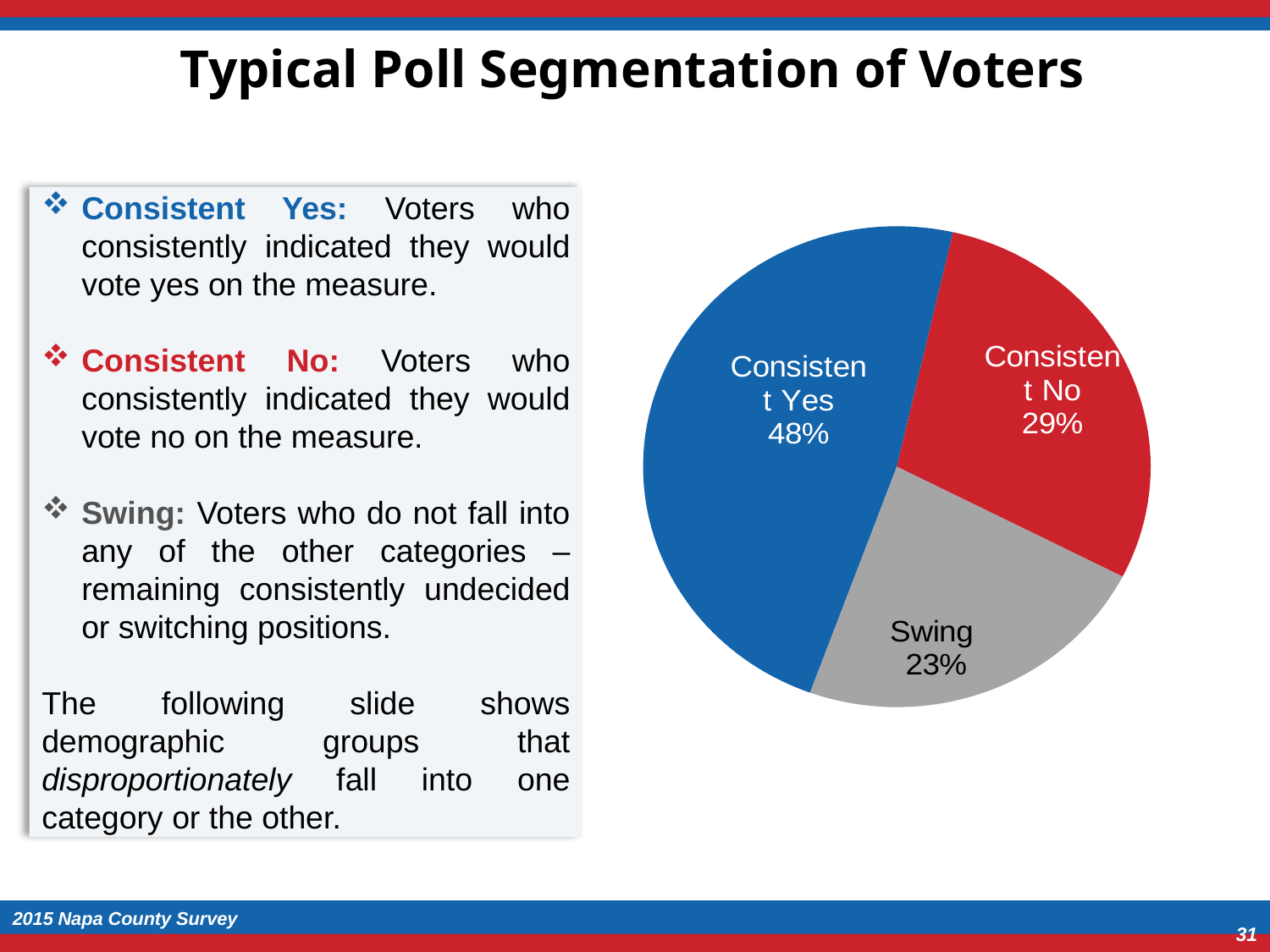
What kind of chart is shown on the slide? pie chart What share of voters are Consistent No? 29% What colour is the Swing slice? gray Which segment is the smallest? Swing What share of voters are Swing? 23% What share of voters are Consistent Yes? 48% How many segments does the pie chart have? 3 Which segment is the largest? Consistent Yes What colour is the Consistent Yes slice? blue Which is larger, Consistent No or Swing? Consistent No What is the difference in percentage points between Consistent Yes and Consistent No? 19 What is the difference in percentage points between Consistent No and Swing? 6